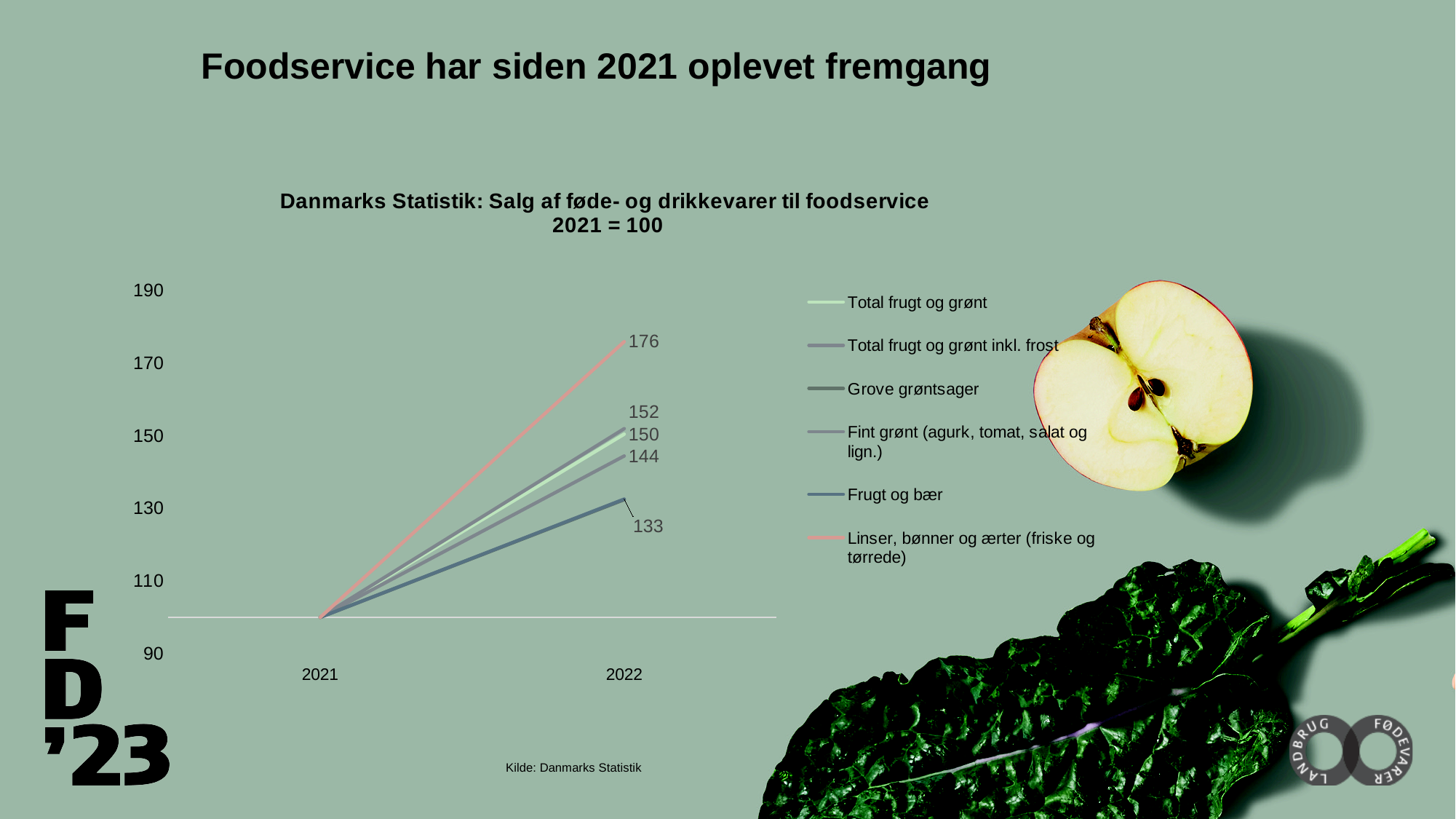
What base year is the index set to 100 in the chart title? 2021 How many series does the legend list? 6 What is the 2022 value for Frugt og bær? 133 What is the 2022 value for Linser, bønner og ærter (friske og tørrede)? 176 What kind of chart is shown on the slide? line chart Which is larger in 2022: Fint grønt (agurk, tomat, salat og lign.) or Frugt og bær? Fint grønt (agurk, tomat, salat og lign.) What is the 2022 value for Fint grønt (agurk, tomat, salat og lign.)? 152 What is the difference between the 2022 values for Linser, bønner og ærter and Frugt og bær? 43 Which series has the highest value in 2022? Linser, bønner og ærter (friske og tørrede) How many years are shown on the x axis? 2 Do the series rise or fall from 2021 to 2022? rise